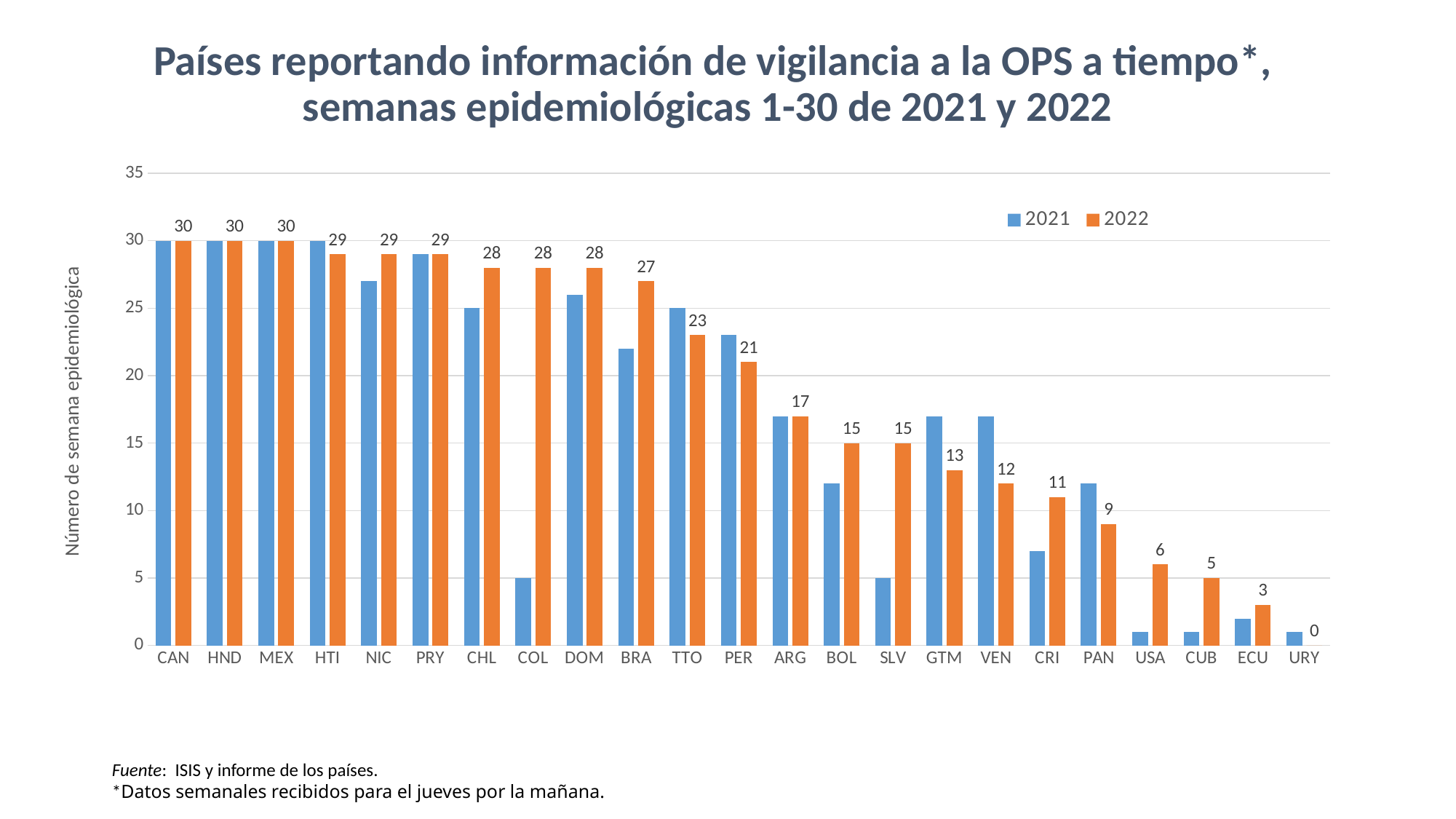
What is the difference between the 2022 values for PER and BOL? 6 What is the 2022 value for TTO? 23 Do the 2022 values rise or fall moving from left to right along the x axis? fall What is the 2022 value for PAN? 9 How many series does the legend list? 2 How many countries are shown on the x axis? 23 Which country has the lowest 2022 value? URY What is the 2022 value for BRA? 27 Is the 2021 value for USA greater or less than 5? less What kind of chart is shown on the slide? bar chart Is the 2021 value for NIC greater or less than 25? greater For COL, which series has the larger value, 2021 or 2022? 2022